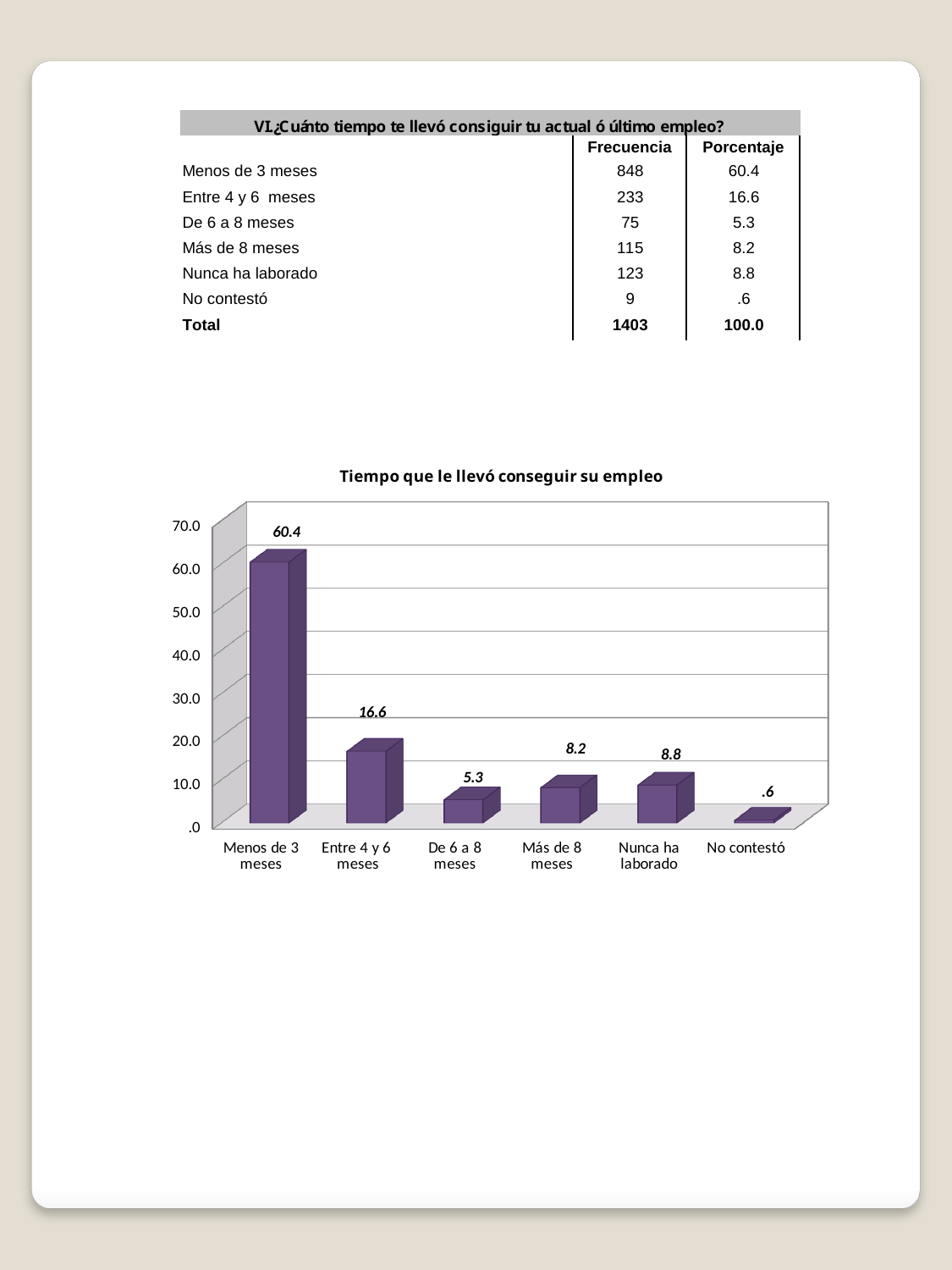
Which category has the highest value in the chart? Menos de 3 meses Is the value for "Entre 4 y 6 meses" greater or less than 20.0? less What is the value for "No contestó" in the chart? .6 What is the value for "Entre 4 y 6 meses" in the chart? 16.6 Which category has the lowest value in the chart? No contestó What kind of chart is shown on the slide? bar chart Which is larger, the value for "Más de 8 meses" or the value for "De 6 a 8 meses"? Más de 8 meses What is the value for "Menos de 3 meses" in the chart? 60.4 What is the title of the chart? Tiempo que le llevó conseguir su empleo What is the value for "Nunca ha laborado" in the chart? 8.8 What is the difference between the values for "Menos de 3 meses" and "Entre 4 y 6 meses"? 43.8 How many categories are shown on the x axis of the chart? 6